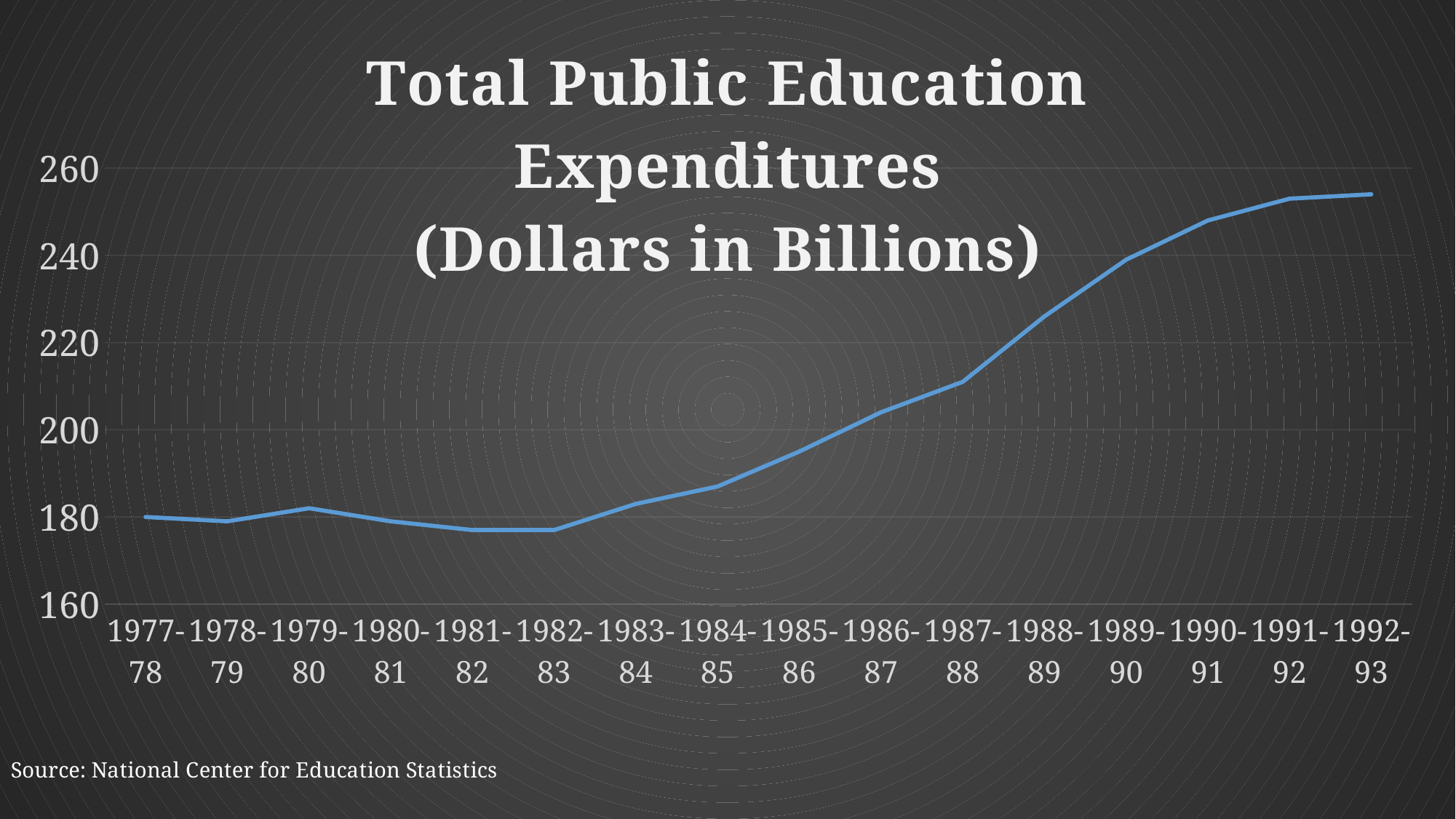
What is the title of the chart? Total Public Education Expenditures (Dollars in Billions) Which is larger, the value for 1979-80 or the value for 1982-83? 1979-80 Is the value for 1992-93 greater or less than 240? greater Which is larger, the value for 1990-91 or the value for 1985-86? 1990-91 Is the value for 1984-85 greater or less than 200? less Is the value for 1987-88 greater or less than 200? greater What source is cited for the chart data? National Center for Education Statistics What kind of chart is shown on the slide? line chart Do the expenditures generally rise or fall from 1982-83 to 1992-93? rise How many school years are plotted on the x axis? 16